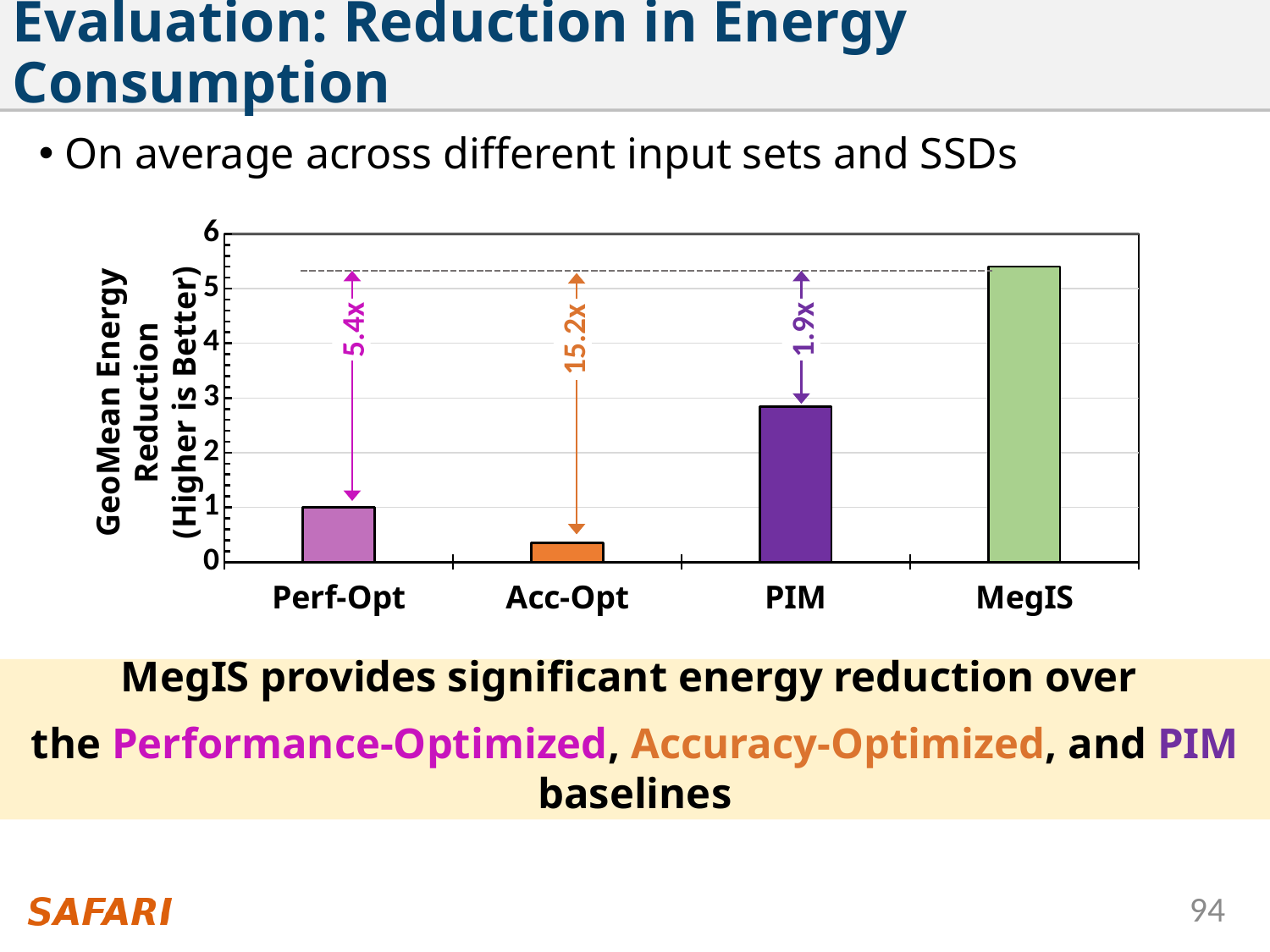
Is the value for PIM greater or less than 3? less Which has a larger GeoMean Energy Reduction, Perf-Opt or Acc-Opt? Perf-Opt What kind of chart is shown on the slide? bar chart What improvement factor is annotated on the arrow above the Acc-Opt bar? 15.2x Is the value for Acc-Opt greater or less than 1? less What improvement factor is annotated on the arrow above the PIM bar? 1.9x How many categories are shown on the x axis of the chart? 4 Which has a larger GeoMean Energy Reduction, PIM or Perf-Opt? PIM Is the value for PIM greater or less than 2? greater Which category has the highest GeoMean Energy Reduction? MegIS Which category has the lowest GeoMean Energy Reduction? Acc-Opt